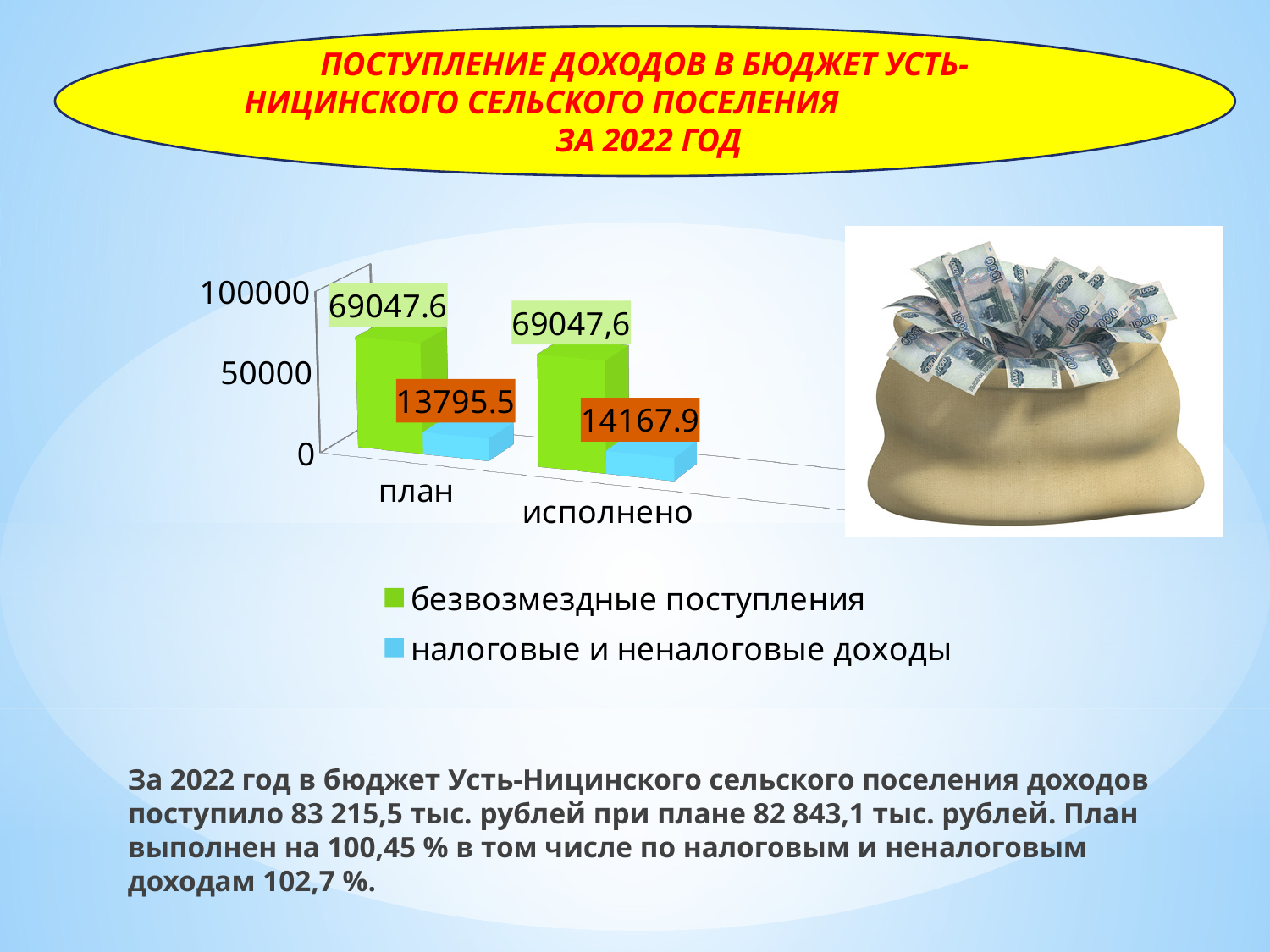
Is the value of безвозмездные поступления for план greater or less than 50000? greater What is the value of безвозмездные поступления for исполнено? 69047,6 Which series has the higher value for план: безвозмездные поступления or налоговые и неналоговые доходы? безвозмездные поступления Which colour represents налоговые и неналоговые доходы in the chart? blue How many series does the chart legend list? 2 What is the value of налоговые и неналоговые доходы for план? 13795.5 What is the difference between the налоговые и неналоговые доходы values for исполнено and план? 372.4 What kind of chart is shown on the slide? bar chart What is the value of безвозмездные поступления for план? 69047.6 How many categories are shown on the x axis of the chart? 2 For налоговые и неналоговые доходы, which category has the larger value: план or исполнено? исполнено What is the value of налоговые и неналоговые доходы for исполнено? 14167.9